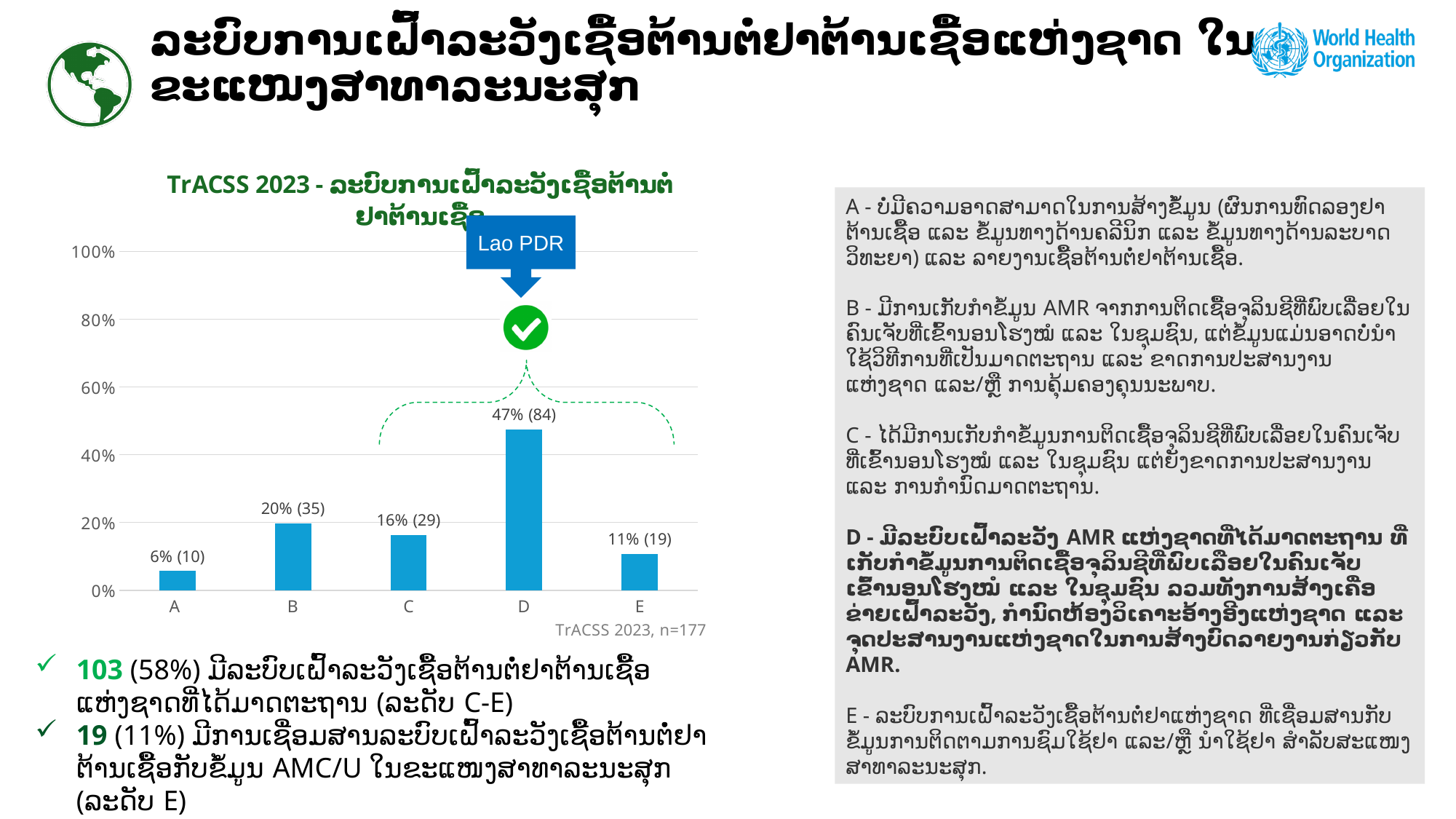
How many categories are shown on the x axis? 5 Which category has the highest value? D What is the value shown for category B? 20% (35) What is the value shown for category D? 47% (84) Which is larger, the value for category C or the value for category E? C Which category does the 'Lao PDR' callout point to? D Is the value for category D greater or less than 40%? greater What kind of chart is shown on the slide? bar chart What is the difference in percentage points between category D and category B? 27% What is the value shown for category A? 6% (10) Which category has the lowest value? A What is the value shown for category E? 11% (19)